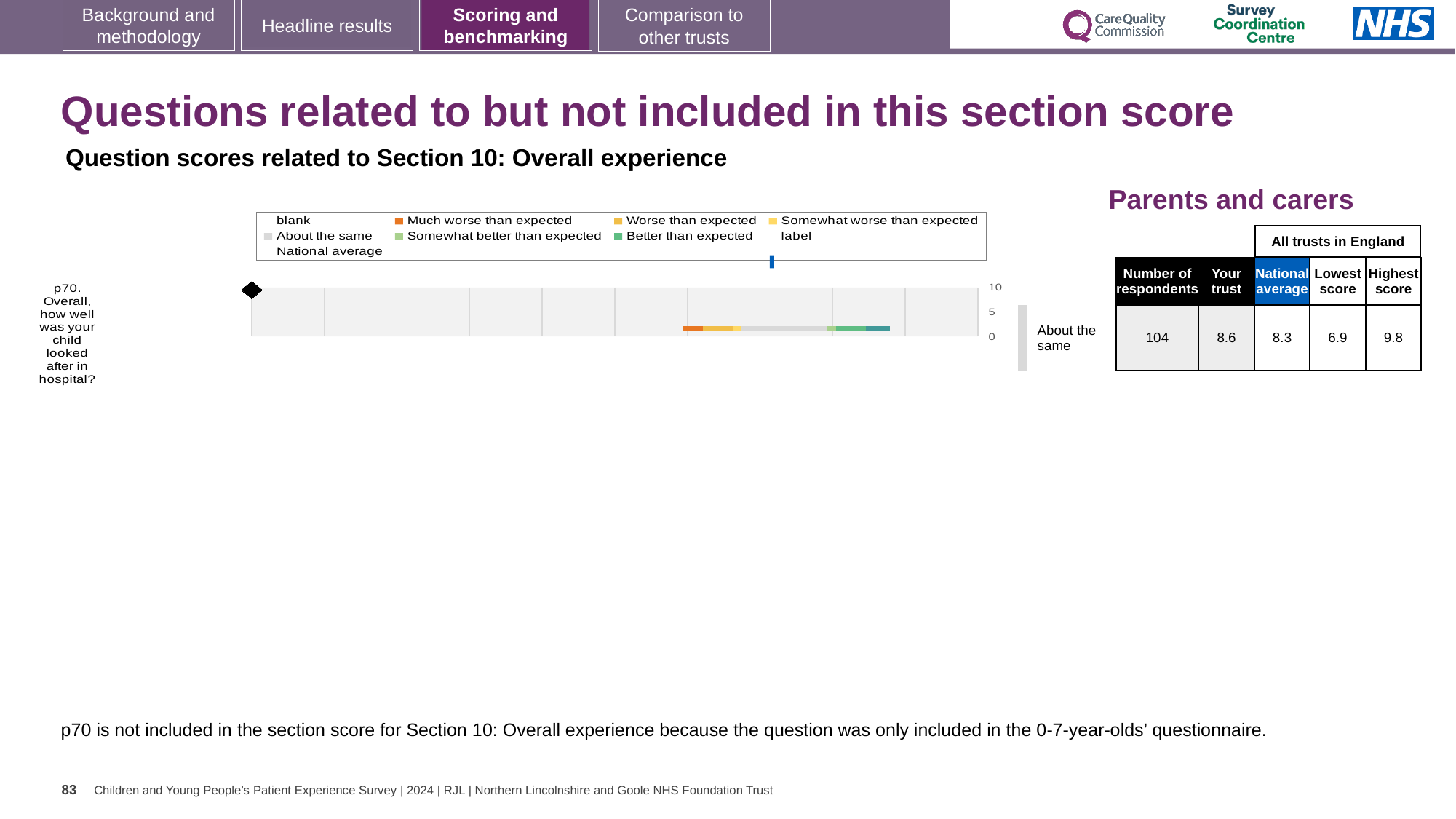
Which is larger for p70, the 'Your trust' score or the national average? Your trust By how much does the 'Your trust' score for p70 exceed the national average? 0.3 What is the lowest score among all trusts in England for p70? 6.9 What is the 'Your trust' score for p70? 8.6 What is the highest score among all trusts in England for p70? 9.8 Which question number is plotted in the chart? p70 What is the difference between the highest and lowest scores for p70? 2.9 How many survey questions are plotted in the chart? 1 What is the national average score for p70? 8.3 What kind of chart is used to show the p70 question score? bar chart What is the number of respondents shown for p70? 104 What comparison label is shown to the right of the p70 bar? About the same